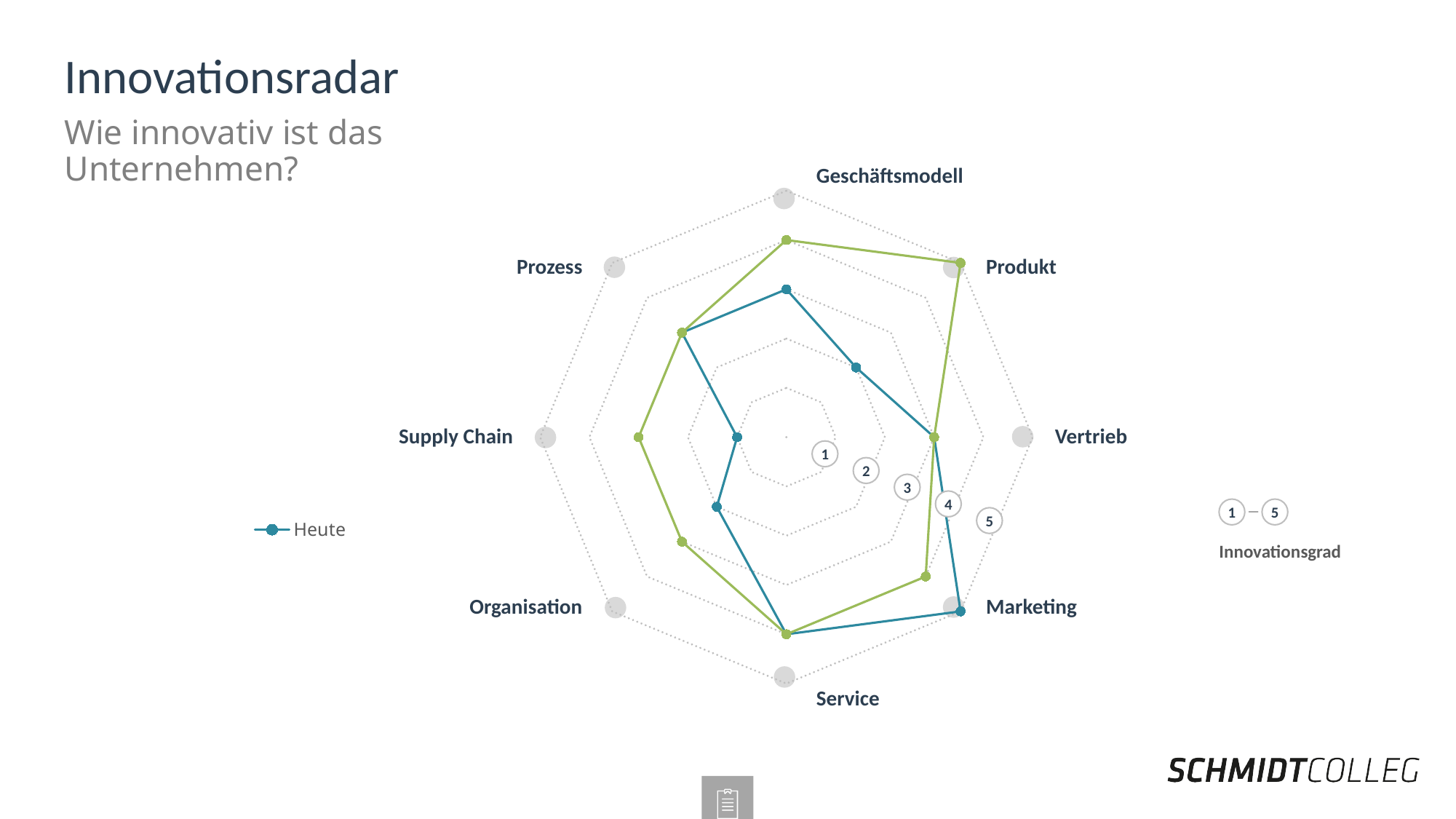
How many categories (axes) does the radar chart have? 8 In which category does the Heute series reach its highest value? Marketing What is the value of the Heute series for Geschäftsmodell? 3 What is the title of the chart on the slide? Innovationsradar How many series does the legend list? 1 What kind of chart is shown on the slide? Radar chart For the Heute series, which is larger: the value for Service or the value for Produkt? Service What is the value of the Heute series for Service? 4 What is the value of the Heute series for Marketing? 5 What is the difference between the Heute values for Marketing and Supply Chain? 4 In which category does the Heute series have its lowest value? Supply Chain What is the value of the Heute series for Supply Chain? 1